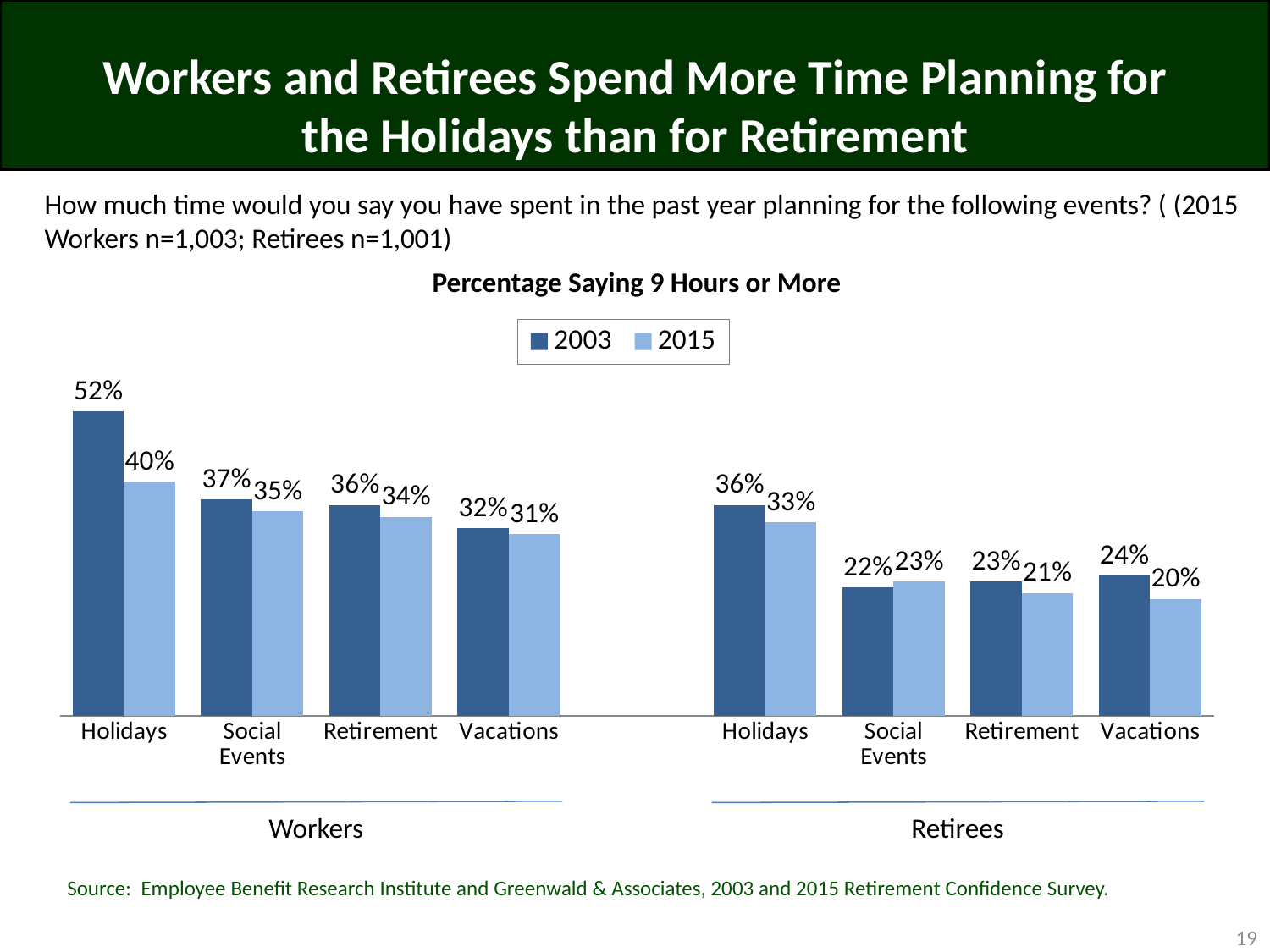
What percentage of Workers said they spent 9 hours or more planning for Vacations in 2015? 31% Among Retirees, which category has the lowest 2015 value? Vacations Among Workers, which category has the highest 2003 value? Holidays For Retirees planning for Social Events, which year has the larger value, 2003 or 2015? 2015 What percentage of Retirees said they spent 9 hours or more planning for Retirement in 2015? 21% What percentage of Workers said they spent 9 hours or more planning for Holidays in 2003? 52% How many series does the legend list? 2 What kind of chart is shown on the slide? Bar chart How many categories are shown for the Workers group? 4 What is the difference between the Workers' and Retirees' 2003 values for Retirement? 13 percentage points What is the difference between the 2003 and 2015 values for Workers planning for Holidays? 12 percentage points What is the title shown above the chart? Percentage Saying 9 Hours or More